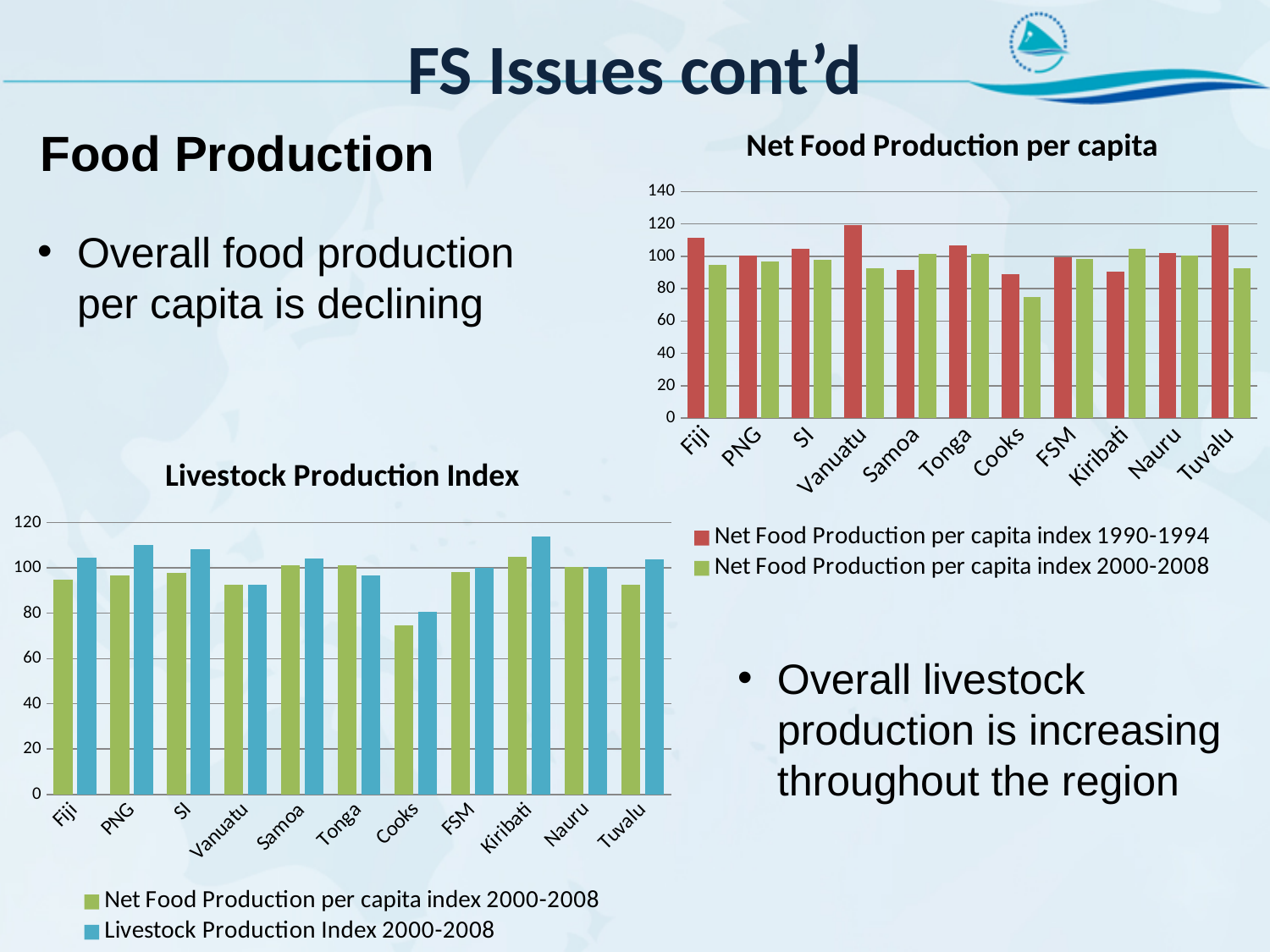
In the "Net Food Production per capita" chart, which country has the lowest value for the 2000-2008 index? Cooks In the "Net Food Production per capita" chart, is the 1990-1994 index value for Vanuatu greater or less than 100? greater In the "Livestock Production Index" chart, which country has the lowest Livestock Production Index 2000-2008 value? Cooks How many series does the legend of the "Net Food Production per capita" chart list? 2 In the "Net Food Production per capita" chart, which is larger for Kiribati: the 1990-1994 index or the 2000-2008 index? 2000-2008 index What type of chart is the "Net Food Production per capita" chart? bar chart In the "Net Food Production per capita" chart, which is larger for Fiji: the 1990-1994 index or the 2000-2008 index? 1990-1994 index In the "Livestock Production Index" chart, is the Livestock Production Index 2000-2008 value for PNG greater or less than 100? greater In the "Net Food Production per capita" chart, what colour are the bars for the 1990-1994 index? red In the "Livestock Production Index" chart, which is larger for Tonga: the Net Food Production per capita index 2000-2008 or the Livestock Production Index 2000-2008? Net Food Production per capita index 2000-2008 How many countries are shown on the x axis of the "Net Food Production per capita" chart? 11 In the "Net Food Production per capita" chart, is the 2000-2008 index value for Cooks greater or less than 80? less